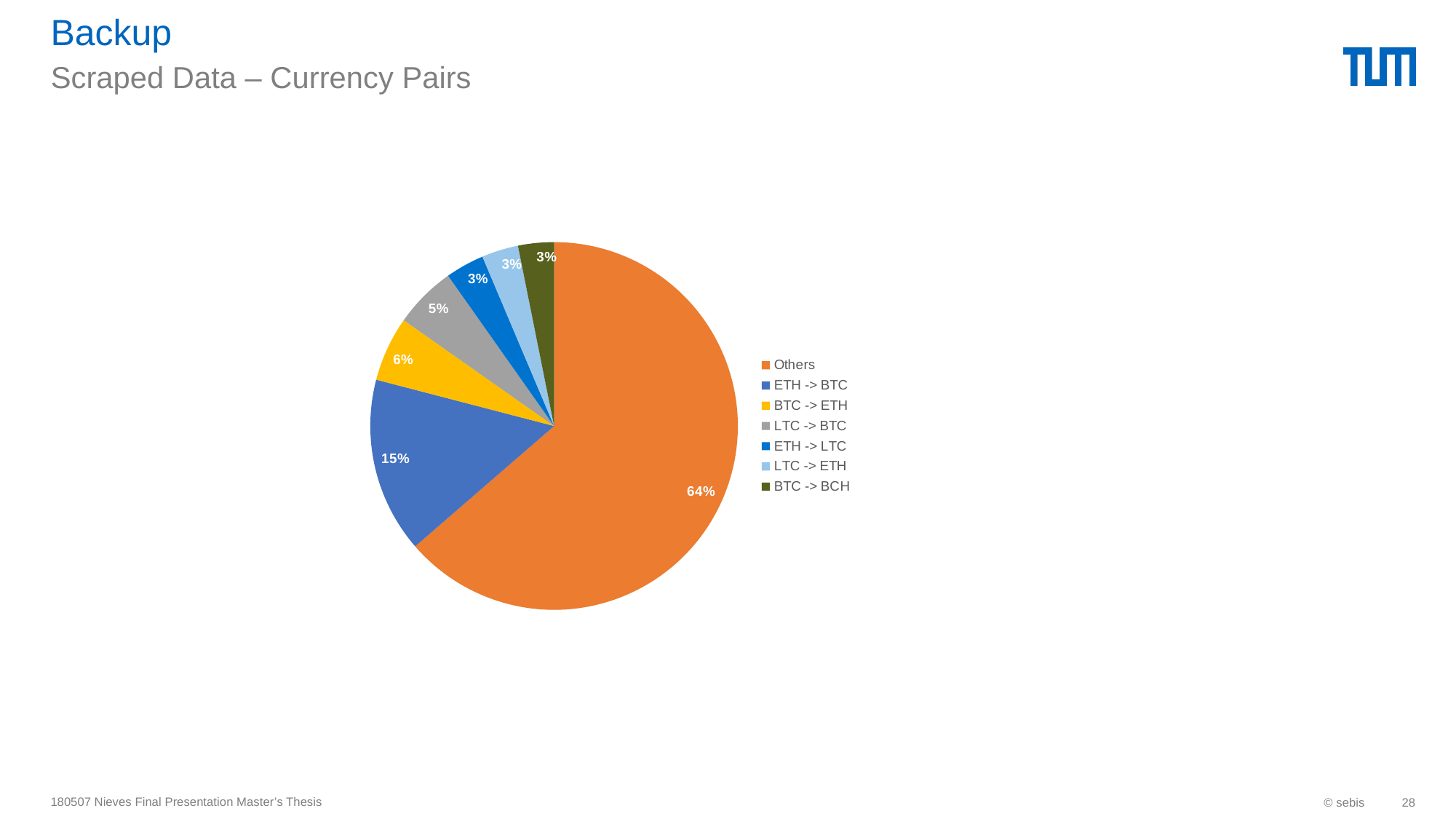
What share of the pie does LTC -> BTC account for? 5% Which category has the largest slice of the pie? Others What is the difference in percentage points between the Others slice and the ETH -> BTC slice? 49 What kind of chart is shown on the slide? Pie chart How many slices does the pie chart have? 7 Which is larger, the BTC -> ETH slice or the LTC -> BTC slice? BTC -> ETH What is the difference in percentage points between the ETH -> BTC slice and the BTC -> ETH slice? 9 What colour is the Others slice in the pie chart? Orange What share of the pie does ETH -> BTC account for? 15% What share of the pie does Others account for? 64%